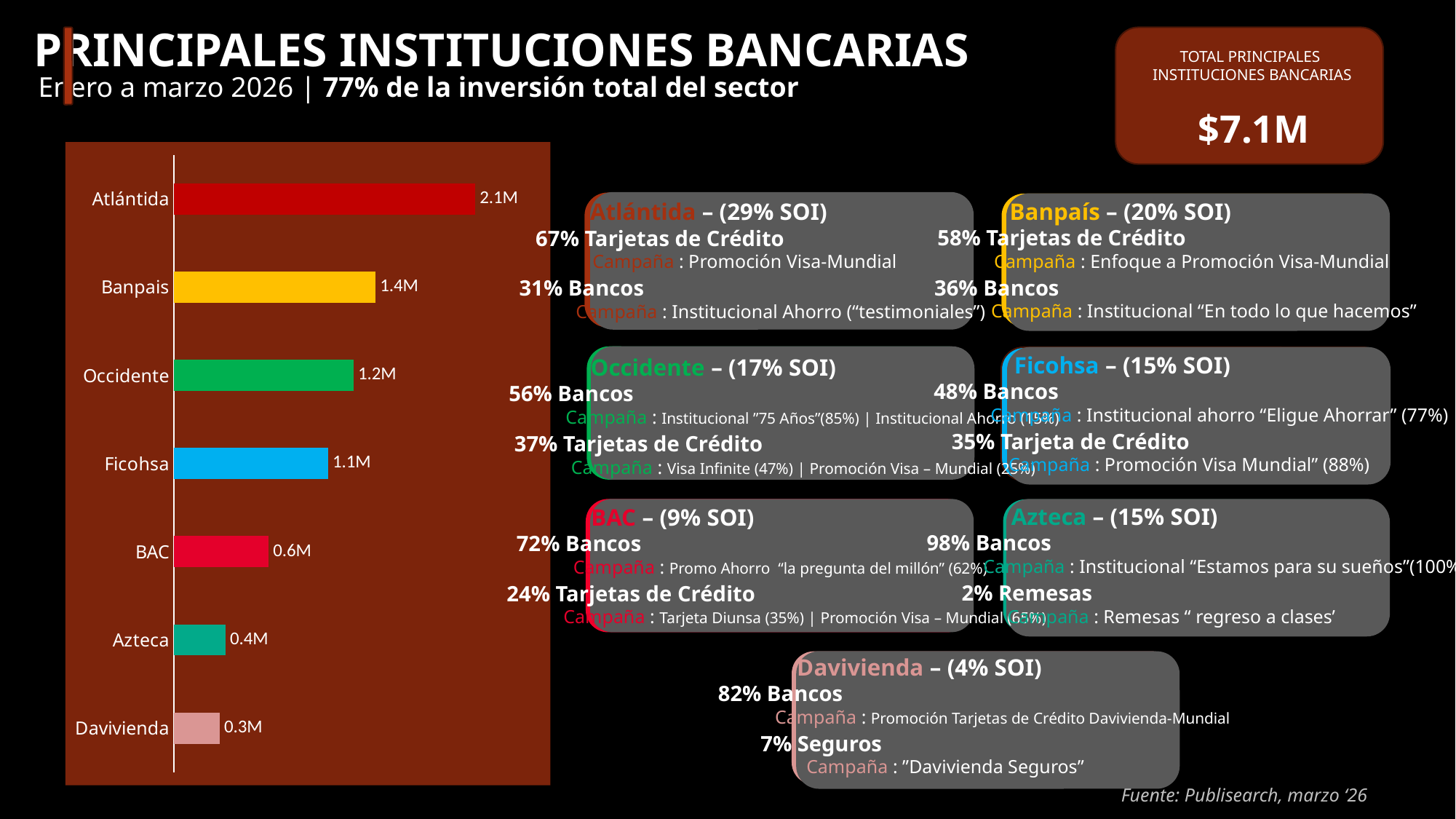
Which has a larger value, Occidente or Ficohsa? Occidente What is the value for Davivienda in the bar chart? 0.3M What colour is the bar for Banpais? Yellow Which institution has the lowest value in the bar chart? Davivienda What is the difference between the values for BAC and Azteca? 0.2M Which has a larger value, Azteca or BAC? BAC Which institution has the highest value in the bar chart? Atlántida How many institutions are shown in the bar chart? 7 What kind of chart is shown on the slide? Bar chart What is the value for Ficohsa in the bar chart? 1.1M What is the value for Atlántida in the bar chart? 2.1M What is the difference between the values for Atlántida and Banpais? 0.7M